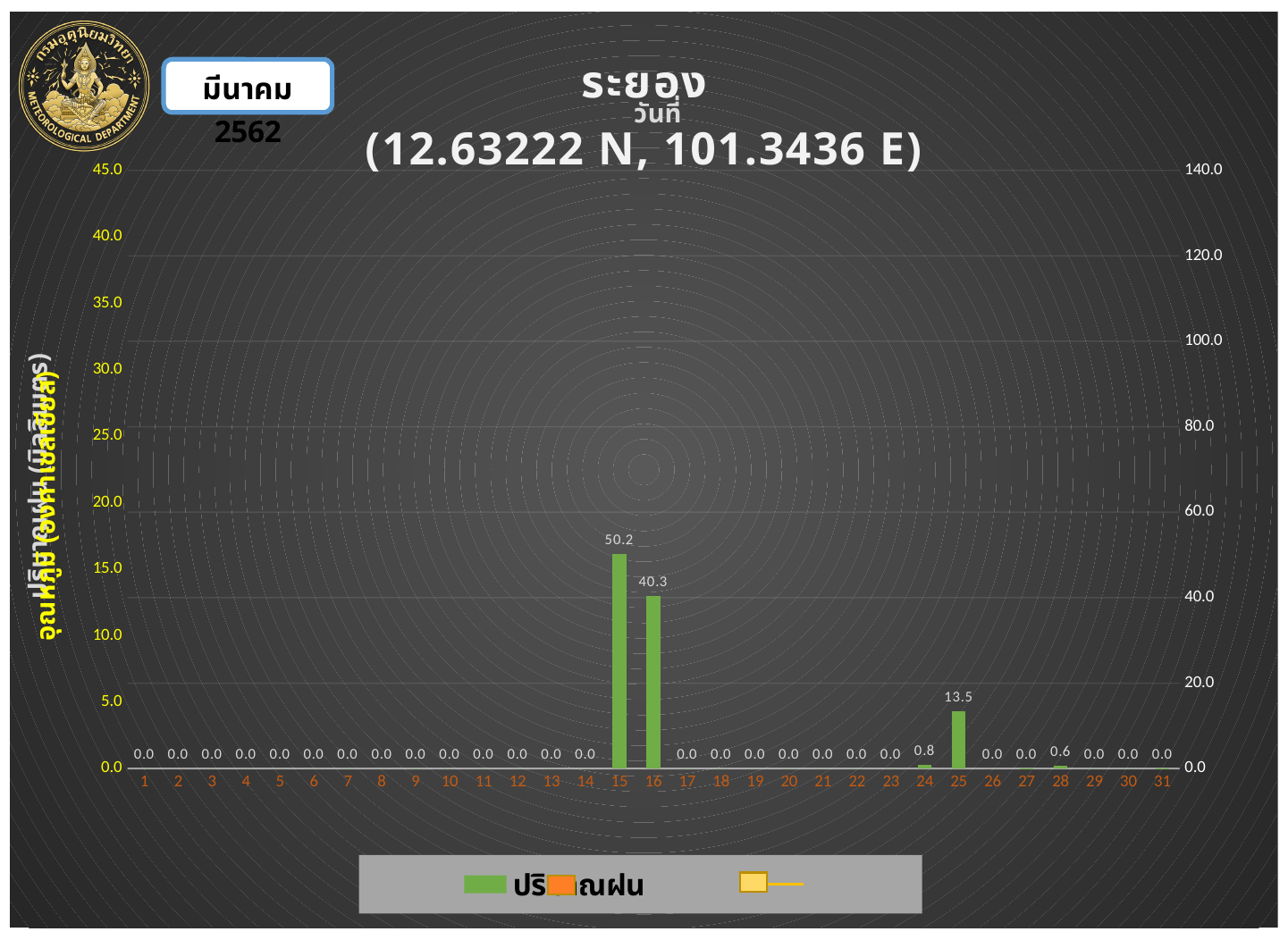
Which day has the highest rainfall value? 15 How many days are shown on the x axis? 31 What is the difference between the rainfall values for day 15 and day 16? 9.9 What is the rainfall value for day 25? 13.5 What is the rainfall value for day 24? 0.8 What is the rainfall value for day 15? 50.2 What is the rainfall value for day 28? 0.6 What is the difference between the rainfall values for day 16 and day 25? 26.8 What type of chart is shown? bar chart What is the rainfall value for day 16? 40.3 Which is larger, the rainfall value for day 25 or for day 24? day 25 What station name appears in the chart title? ระยอง